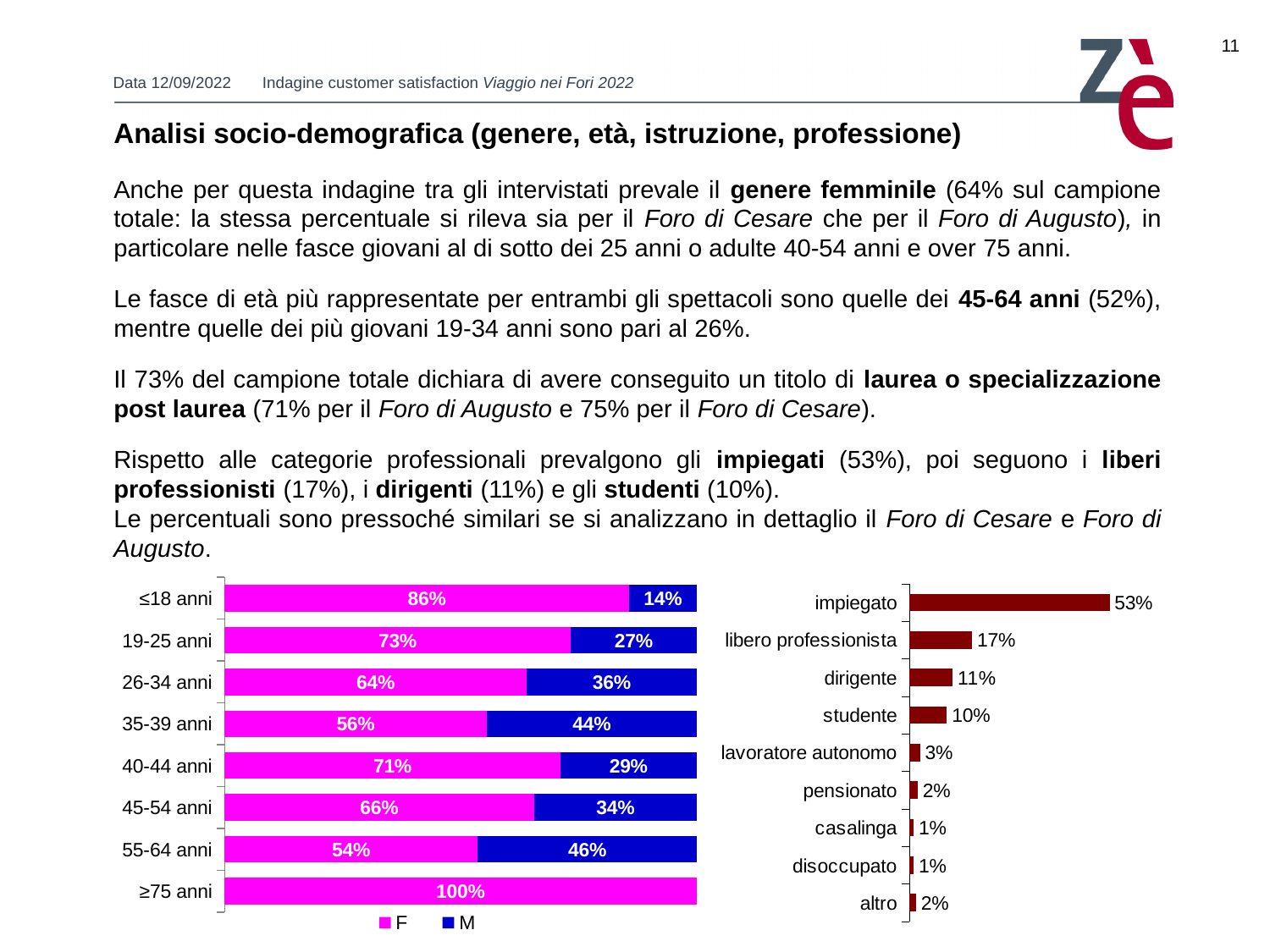
In the left chart (gender by age group), which age group has the lowest value for F? 55-64 anni In the left chart (gender by age group), what is the value for M in the 35-39 anni category? 44% What kind of chart is the right chart (profession)? bar chart In the right chart (profession), which is larger: studente or lavoratore autonomo? studente In the right chart (profession), what is the value for dirigente? 11% In the left chart (gender by age group), how many age groups are shown? 8 In the right chart (profession), which category has the highest value? impiegato In the right chart (profession), what is the difference between impiegato and libero professionista? 36% In the left chart (gender by age group), how many series does the legend list? 2 In the left chart (gender by age group), what is the value for F in the 19-25 anni category? 73% In the left chart (gender by age group), what is the difference between the F and M values for 45-54 anni? 32% In the left chart (gender by age group), which age group has the highest value for M? 55-64 anni